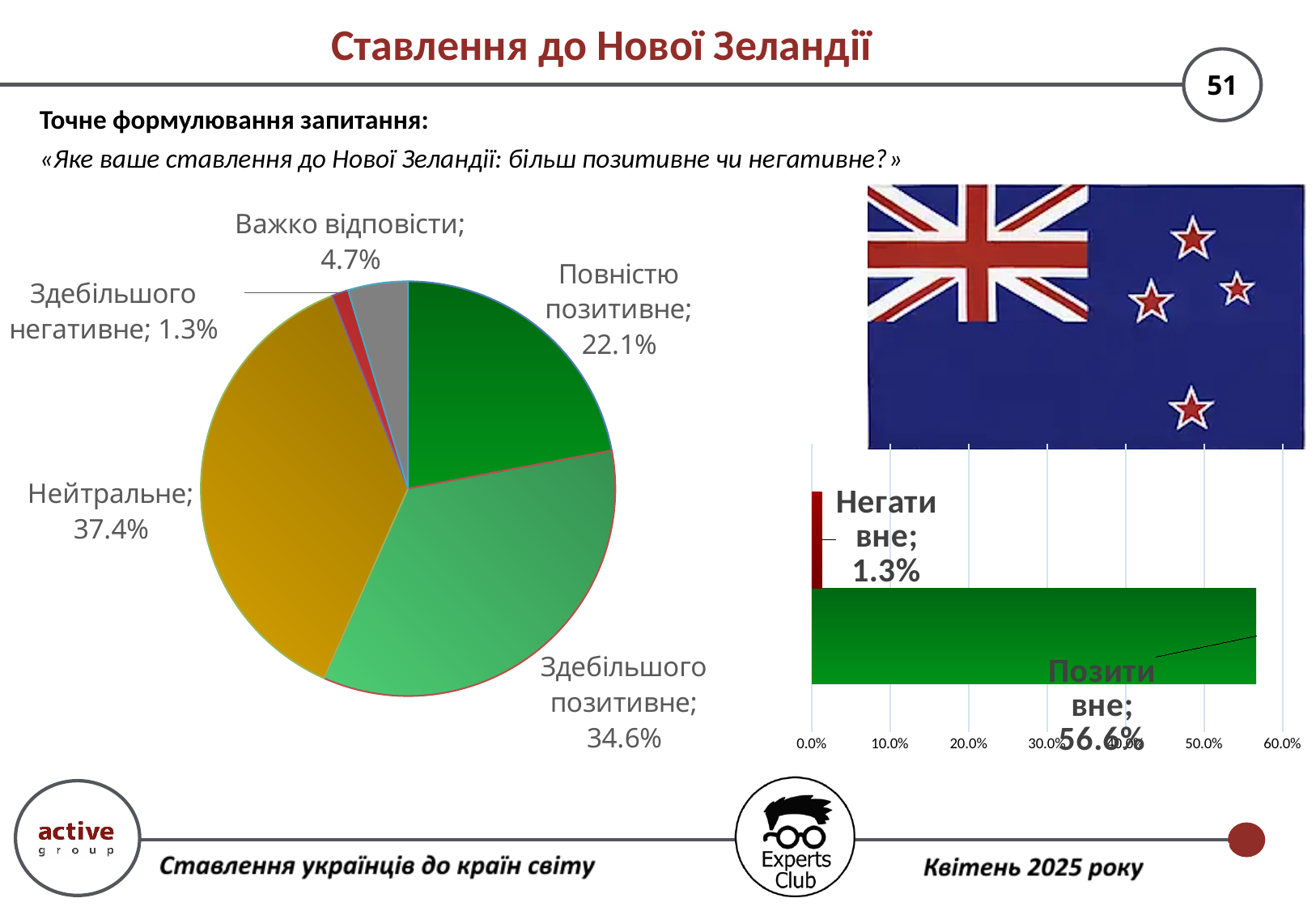
In the bar chart on the right, what is the value for «Позитивне»? 56.6% What type of chart is shown on the left of the slide? Pie chart In the pie chart, which category has the largest share? Нейтральне In the pie chart, what share of respondents answered «Важко відповісти»? 4.7% How many slices does the pie chart have? 5 In the bar chart on the right, what is the value for «Негативне»? 1.3% In the pie chart, which is larger: «Повністю позитивне» or «Здебільшого позитивне»? Здебільшого позитивне In the pie chart, what is the difference between «Нейтральне» and «Здебільшого позитивне»? 2.8% In the pie chart, which category has the smallest share? Здебільшого негативне In the pie chart, what share of respondents answered «Повністю позитивне»? 22.1% In the bar chart on the right, what is the difference between «Позитивне» and «Негативне»? 55.3% In the pie chart, what share of respondents answered «Нейтральне»? 37.4%